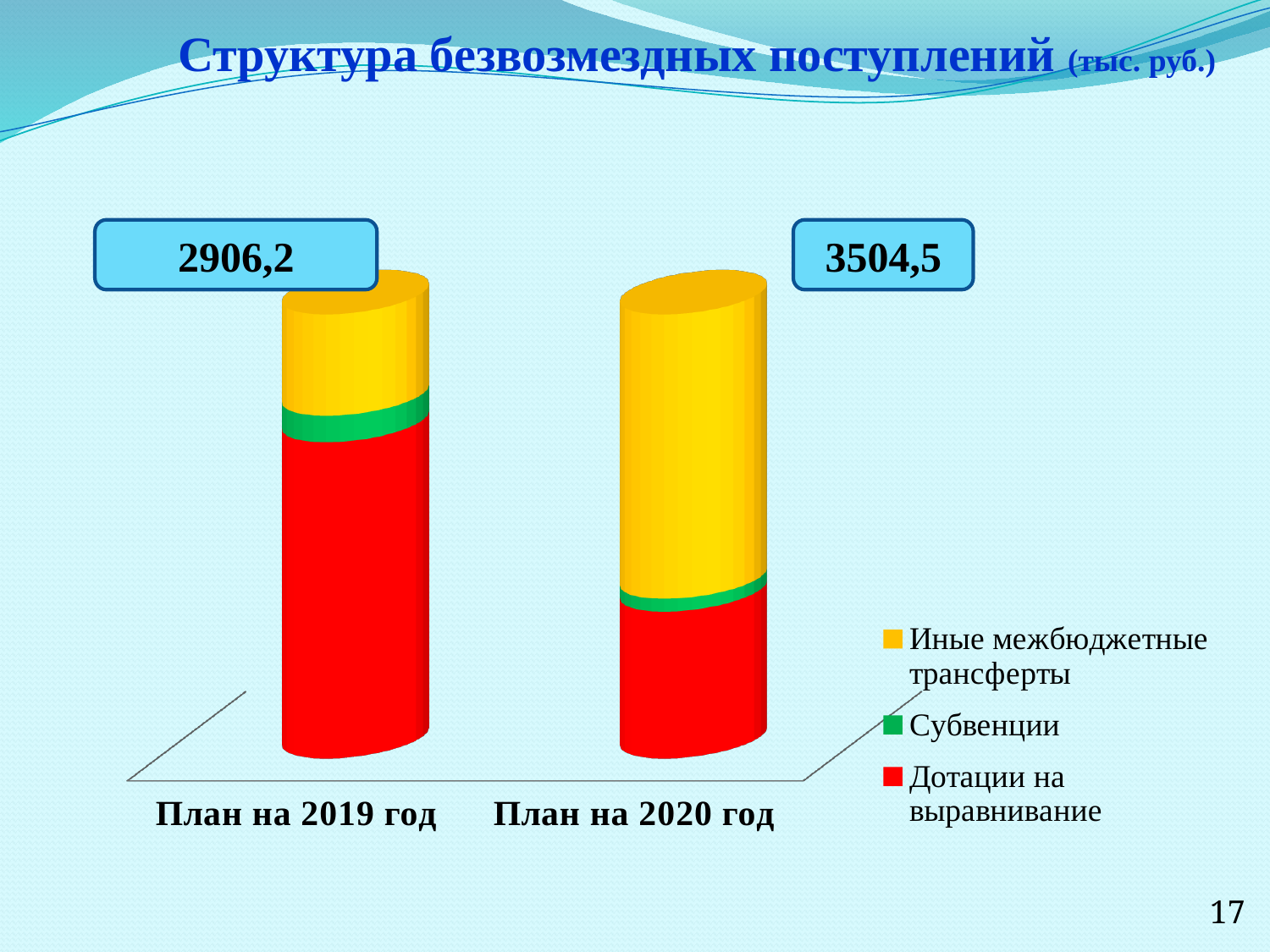
Which colour represents "Субвенции" in the legend? Green Which bar has the larger total, "План на 2019 год" or "План на 2020 год"? План на 2020 год What is the total value shown for "План на 2020 год"? 3504,5 In the "План на 2019 год" bar, which segment is larger: "Дотации на выравнивание" or "Иные межбюджетные трансферты"? Дотации на выравнивание What is the difference between the totals for "План на 2020 год" and "План на 2019 год"? 598,3 Do the total values rise or fall from "План на 2019 год" to "План на 2020 год"? Rise How many series does the legend list? 3 Which series has the smallest segment in both bars? Субвенции In the "План на 2020 год" bar, which segment is larger: "Дотации на выравнивание" or "Иные межбюджетные трансферты"? Иные межбюджетные трансферты How many categories (bars) are shown on the x axis? 2 What is the total value shown for "План на 2019 год"? 2906,2 What kind of chart is shown on the slide? Stacked bar chart